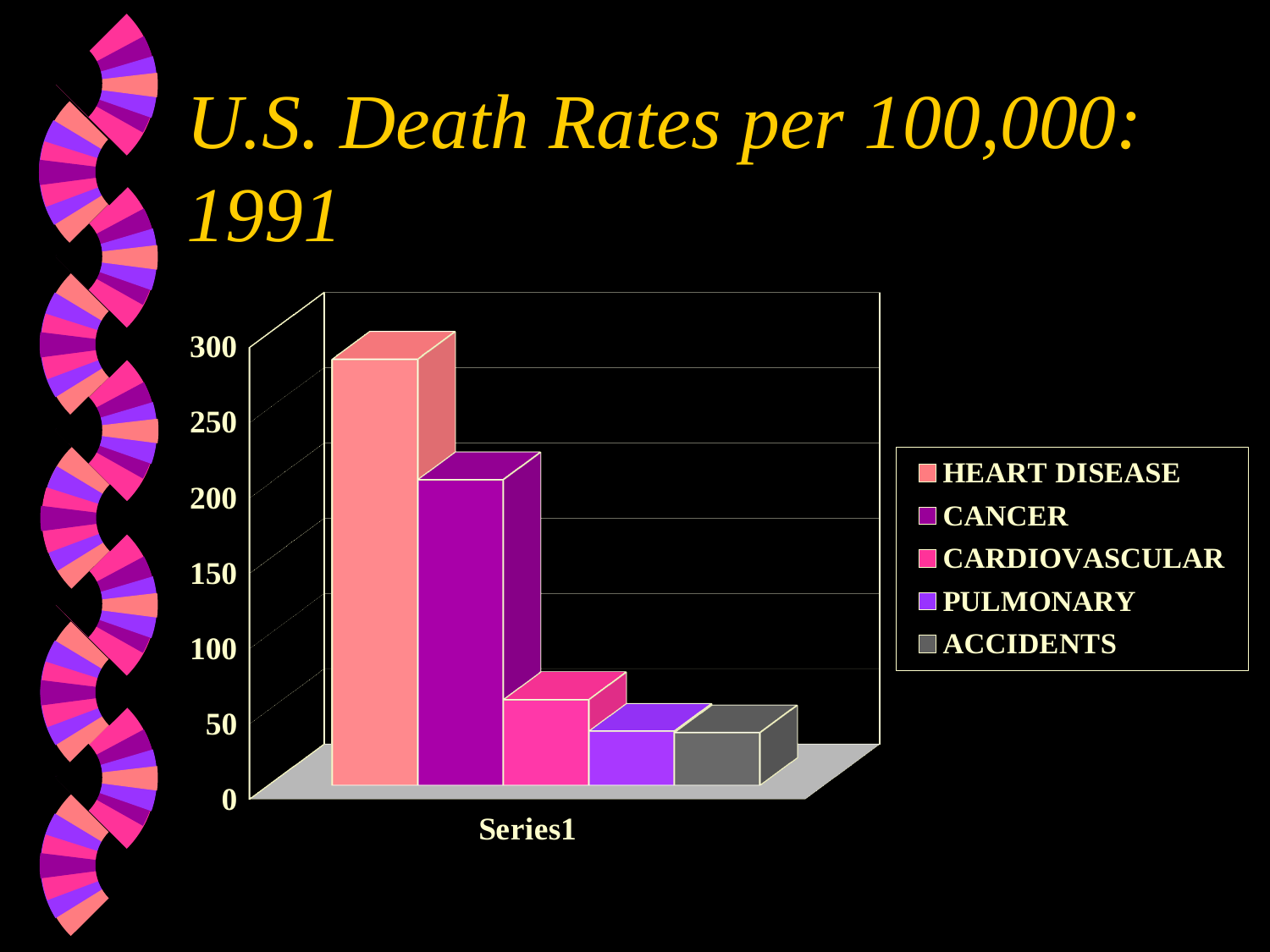
Is the value for CANCER greater or less than 150? greater Which category has the highest death rate in the chart? HEART DISEASE Is the value for CARDIOVASCULAR greater or less than 100? less Which is larger, the value for HEART DISEASE or the value for CANCER? HEART DISEASE How many entries does the legend list? 5 What is the title of the slide's chart? U.S. Death Rates per 100,000: 1991 Which is larger, the value for CANCER or the value for CARDIOVASCULAR? CANCER How many bars are plotted in the chart? 5 Is the value for HEART DISEASE greater or less than 250? greater What kind of chart is shown on the slide? bar chart